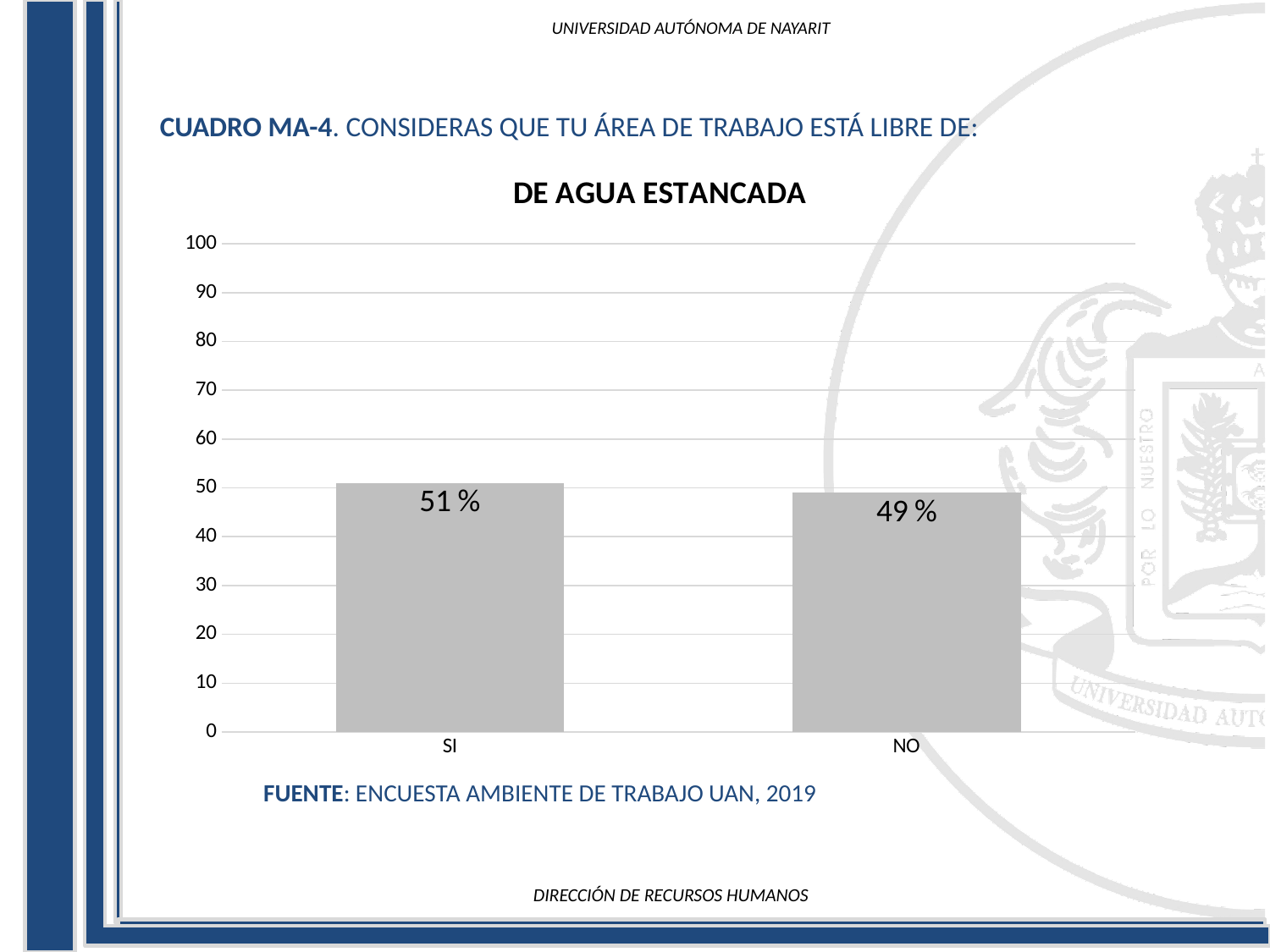
Is the value for SI greater or less than 40? greater Which category has the highest value? SI What is the title of the chart? DE AGUA ESTANCADA What kind of chart is shown on the slide? bar chart What is the value for NO? 49 % What is the difference between the values for SI and NO? 2 % Which category has the lowest value? NO Which is larger, the value for SI or the value for NO? SI Is the value for NO greater or less than 60? less What is the highest value shown on the y axis? 100 How many categories are shown on the x axis? 2 What is the value for SI? 51 %